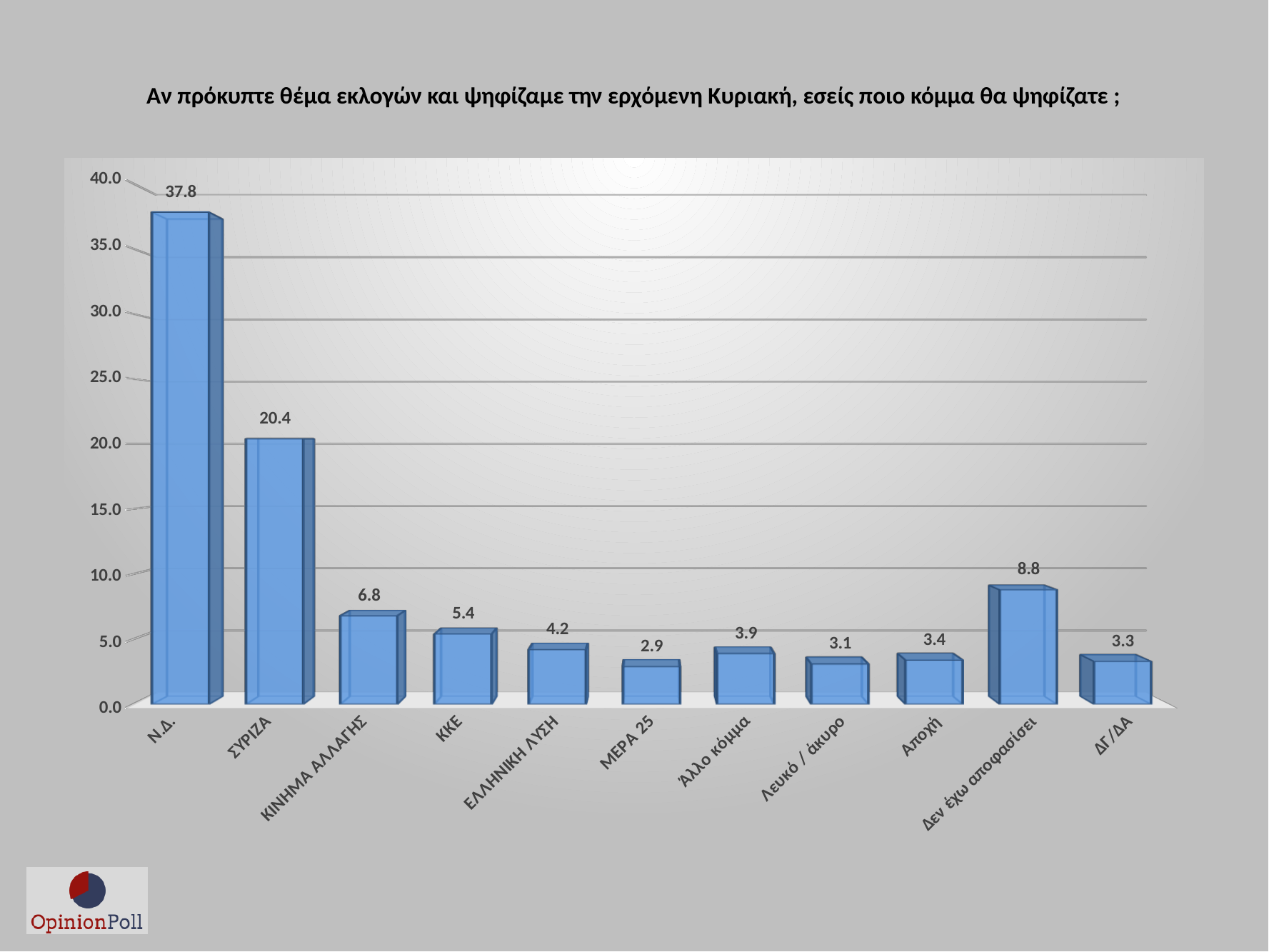
What is the value for Ν.Δ.? 37.8 Which category has the highest value? Ν.Δ. What is the difference between the values for ΕΛΛΗΝΙΚΗ ΛΥΣΗ and Λευκό / άκυρο? 1.1 Which is larger, the value for ΚΚΕ or the value for ΚΙΝΗΜΑ ΑΛΛΑΓΗΣ? ΚΙΝΗΜΑ ΑΛΛΑΓΗΣ What is the value for Δεν έχω αποφασίσει? 8.8 What is the value for ΜΕΡΑ 25? 2.9 What is the value for ΣΥΡΙΖΑ? 20.4 What kind of chart is shown on the slide? bar chart Is the value for ΣΥΡΙΖΑ greater or less than 25.0? less Which category has the lowest value? ΜΕΡΑ 25 What is the difference between the values for Ν.Δ. and ΣΥΡΙΖΑ? 17.4 How many categories are shown on the x axis? 11